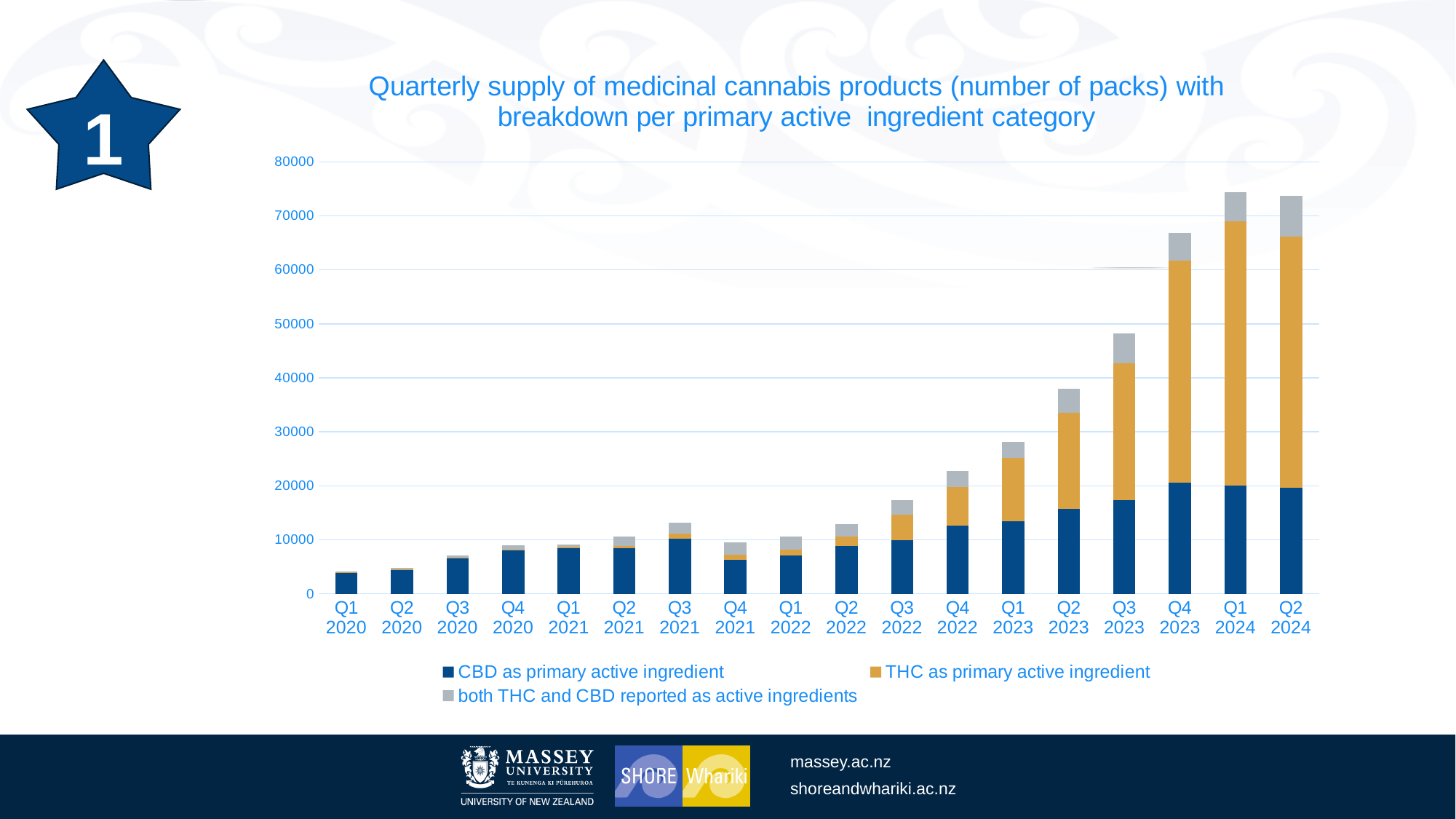
Which quarter has the larger total supply, Q3 2021 or Q4 2021? Q3 2021 Is the total number of packs for Q1 2023 greater or less than 30000? less What kind of chart is shown on the slide? Stacked bar chart How many series does the legend list? 3 Is the total number of packs for Q3 2023 greater or less than 50000? less How many quarters are shown along the x axis? 18 Is the total number of packs for Q4 2023 greater or less than 60000? greater Do the total quarterly supply values generally rise or fall from Q1 2020 to Q2 2024? rise Which quarter has the lowest total supply of packs? Q1 2020 What is the title of the chart? Quarterly supply of medicinal cannabis products (number of packs) with breakdown per primary active ingredient category Which series is shown in the orange/gold colour? THC as primary active ingredient